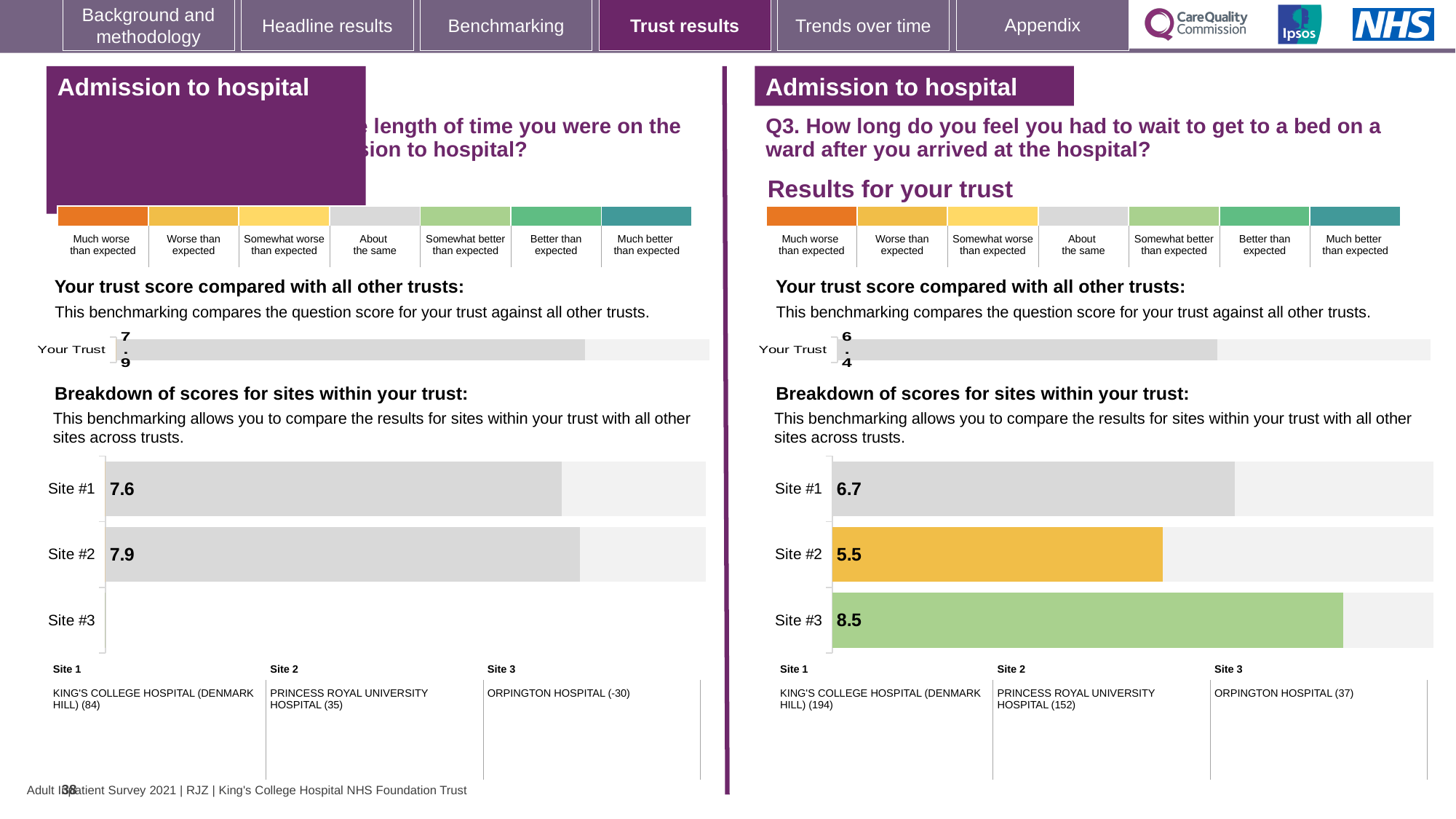
On the left-hand chart (breakdown of scores for sites), what is the score for Site #2? 7.9 On the left-hand chart, which site scores higher, Site #1 or Site #2? Site #2 On the right-hand chart (Q3), what colour is the bar for Site #2? Yellow/orange On the right-hand chart (Q3), what is the score for Site #2? 5.5 On the right-hand chart (Q3), which site scores higher, Site #1 or Site #2? Site #1 On the right-hand chart (Q3), which site has the lowest score? Site #2 On the left-hand chart (breakdown of scores for sites), what is the score for Site #1? 7.6 On the right-hand chart (Q3), what is the difference between the scores for Site #3 and Site #2? 3.0 On the right-hand chart (Q3), what is the score for Site #3? 8.5 What type of chart is used to show the breakdown of scores for sites on the right-hand side of the slide? Bar chart On the right-hand chart (Q3, wait to get to a bed on a ward), what is the score for Site #1? 6.7 On the right-hand chart (Q3), which site has the highest score? Site #3